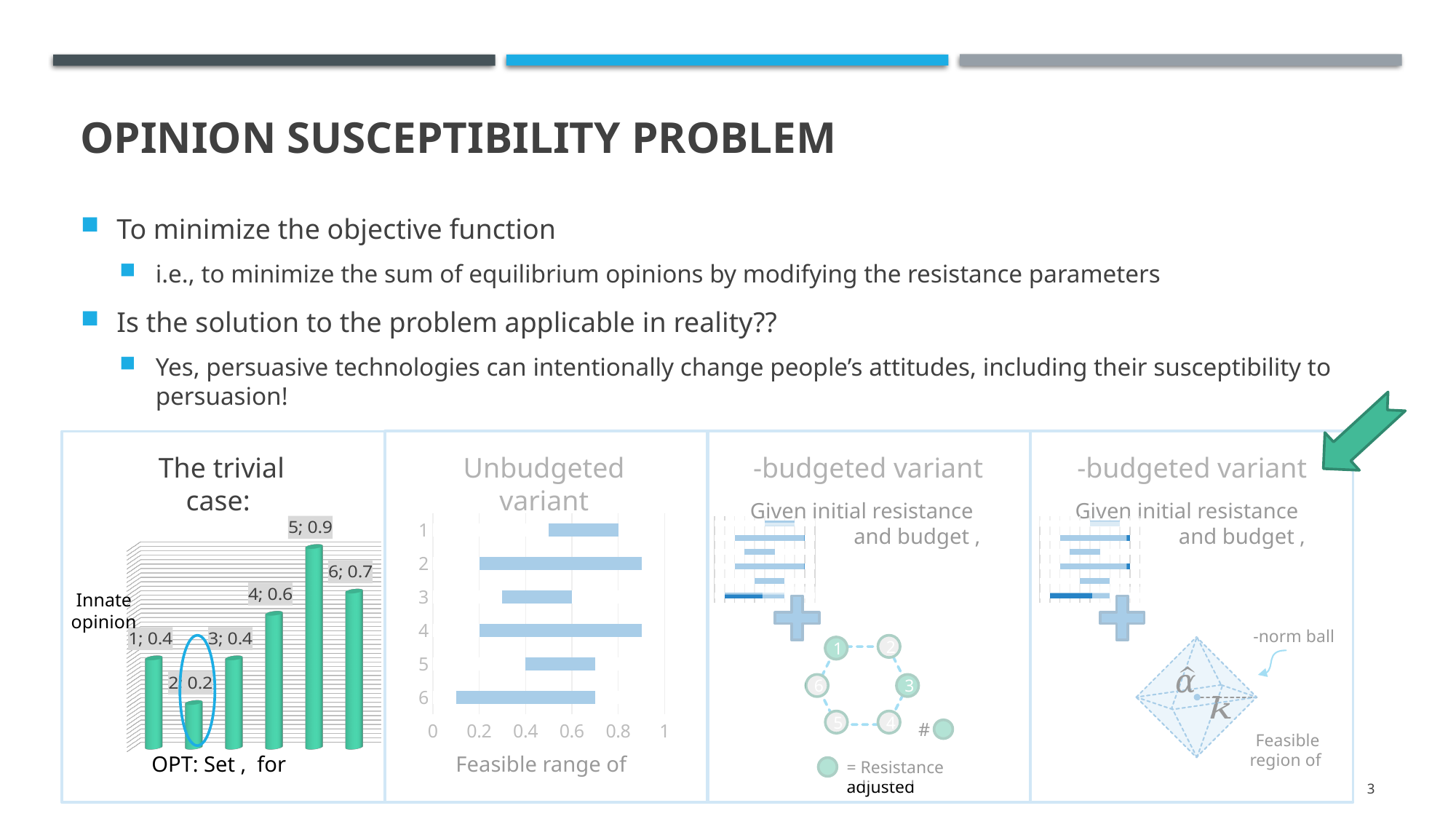
What kind of chart is shown in the panel titled 'The trivial case'? bar chart In the chart titled 'The trivial case', what is the value shown for category 2? 0.2 In the chart titled 'The trivial case', which is larger, the value for category 6 or the value for category 4? category 6 In the chart titled 'The trivial case', what is the difference between the values for category 5 and category 2? 0.7 How many bars are plotted in the chart titled 'The trivial case'? 6 In the chart titled 'The trivial case', what is the value shown for category 4? 0.6 In the chart titled 'The trivial case', what is the value shown for category 5? 0.9 In the chart titled 'The trivial case', which category has the highest value? 5 In the chart titled 'The trivial case', which category has the lowest value? 2 How many categories are listed on the vertical axis of the chart in the 'Unbudgeted variant' panel? 6 What kind of chart is shown in the panel titled 'Unbudgeted variant'? bar chart In the 'Unbudgeted variant' chart, does the bar for category 2 extend past 0.8 on the horizontal axis? yes